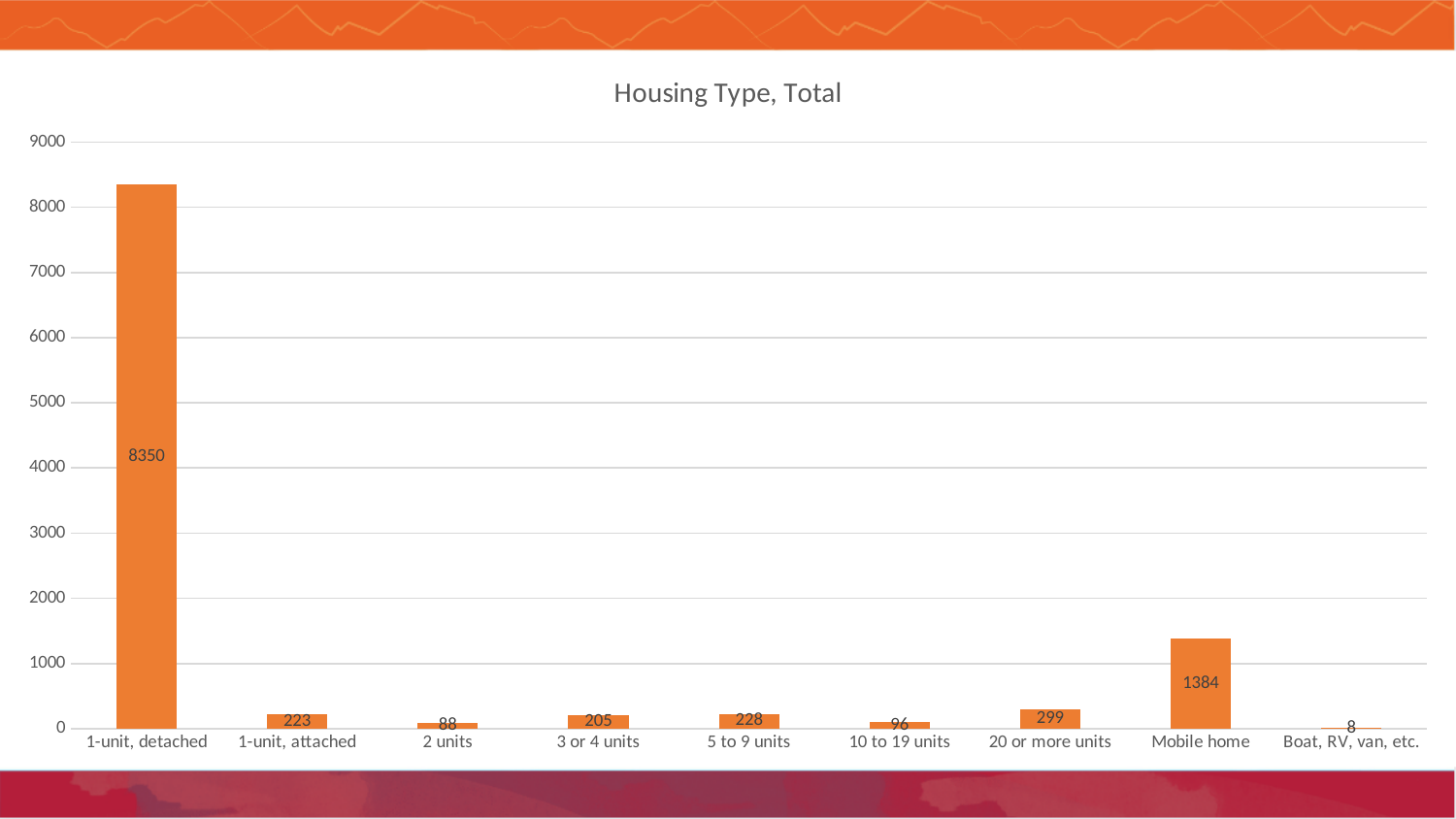
What is the value for 1-unit, detached? 8350 Which is larger, the value for 5 to 9 units or the value for 3 or 4 units? 5 to 9 units What kind of chart is shown on the slide? bar chart What is the value for 20 or more units? 299 What is the title of the chart? Housing Type, Total Is the value for Mobile home greater or less than 1000? greater Which housing type has the lowest total? Boat, RV, van, etc. How many housing type categories are shown on the chart? 9 What is the difference between the values for 1-unit, detached and Mobile home? 6966 What is the value for Mobile home? 1384 What is the value for Boat, RV, van, etc.? 8 Which housing type has the highest total? 1-unit, detached